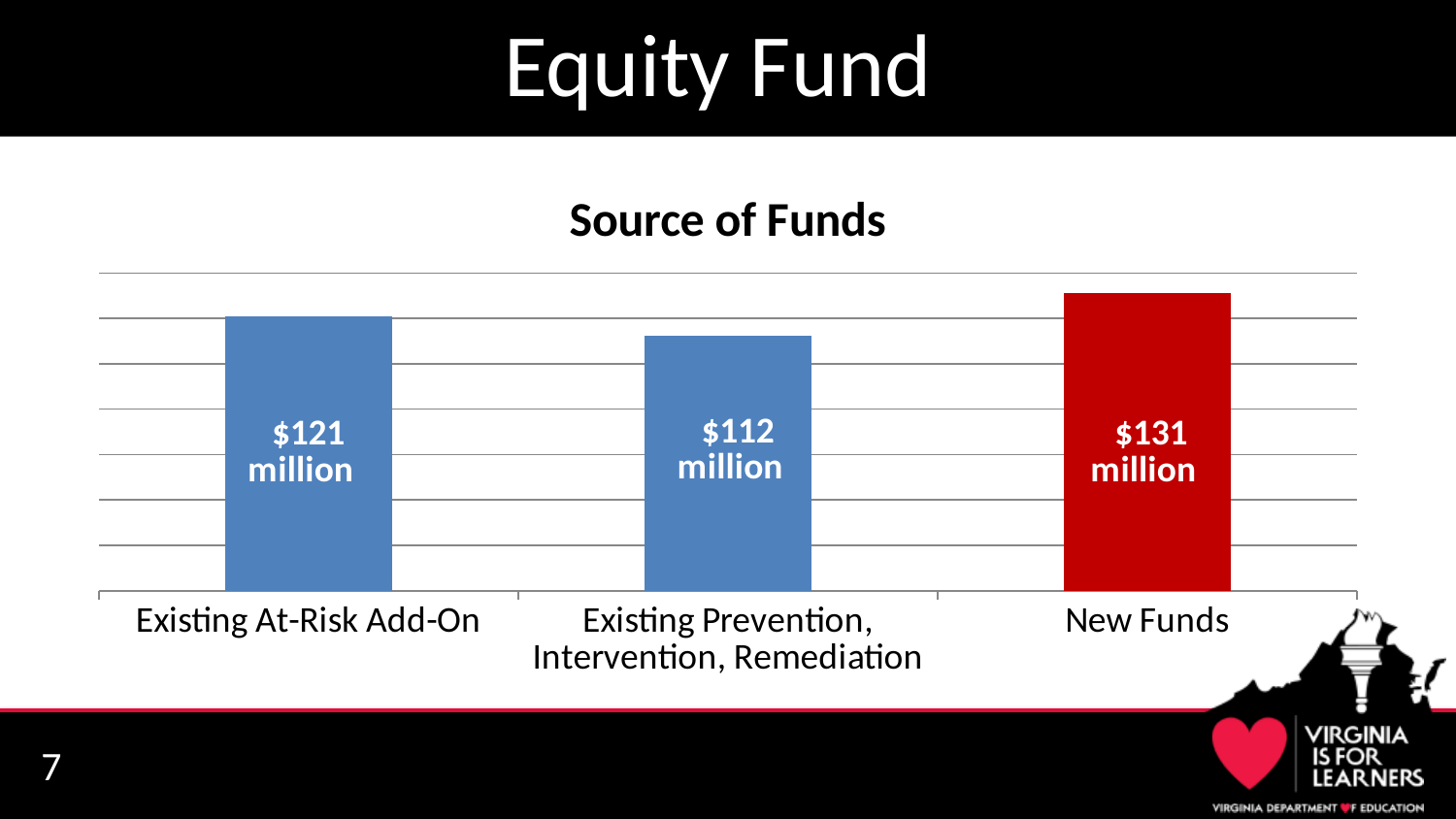
What is the value for Existing Prevention, Intervention, Remediation? $112 million What is the difference between New Funds and Existing At-Risk Add-On? $10 million What is the value for Existing At-Risk Add-On? $121 million What is the difference between Existing At-Risk Add-On and Existing Prevention, Intervention, Remediation? $9 million Which category has the lowest value? Existing Prevention, Intervention, Remediation What is the title of the chart? Source of Funds Which is larger, Existing At-Risk Add-On or New Funds? New Funds Which bar is coloured red rather than blue? New Funds What is the value for New Funds? $131 million What kind of chart is shown? Bar chart How many categories are shown in the chart? 3 Which category has the highest value? New Funds